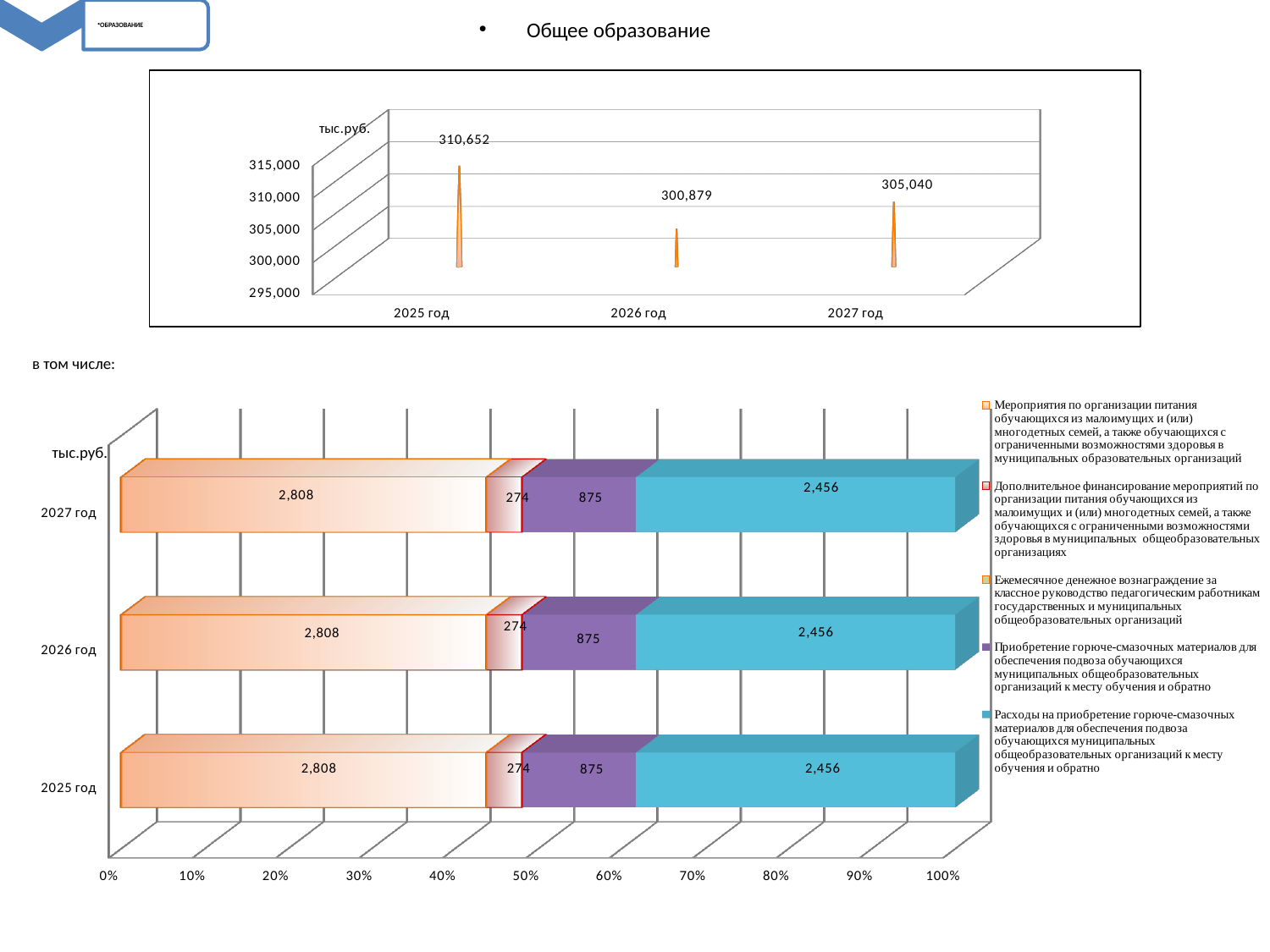
In the top chart, which year has the highest value? 2025 год In the top chart, which year has the lowest value? 2026 год In the top chart, what is the difference between the values for 2025 год and 2026 год? 9,773 In the top chart, how many years are plotted? 3 In the bottom chart, what is the value of the blue segment for 2025 год? 2,456 In the bottom chart, how many series does the legend list? 5 In the top chart, what is the value for 2027 год? 305,040 What kind of chart is the bottom chart? Stacked bar chart In the top chart, what is the value for 2025 год? 310,652 In the top chart, what is the value for 2026 год? 300,879 In the top chart, which is larger, the value for 2027 год or the value for 2026 год? 2027 год In the bottom chart, what is the value of the purple segment for 2026 год? 875